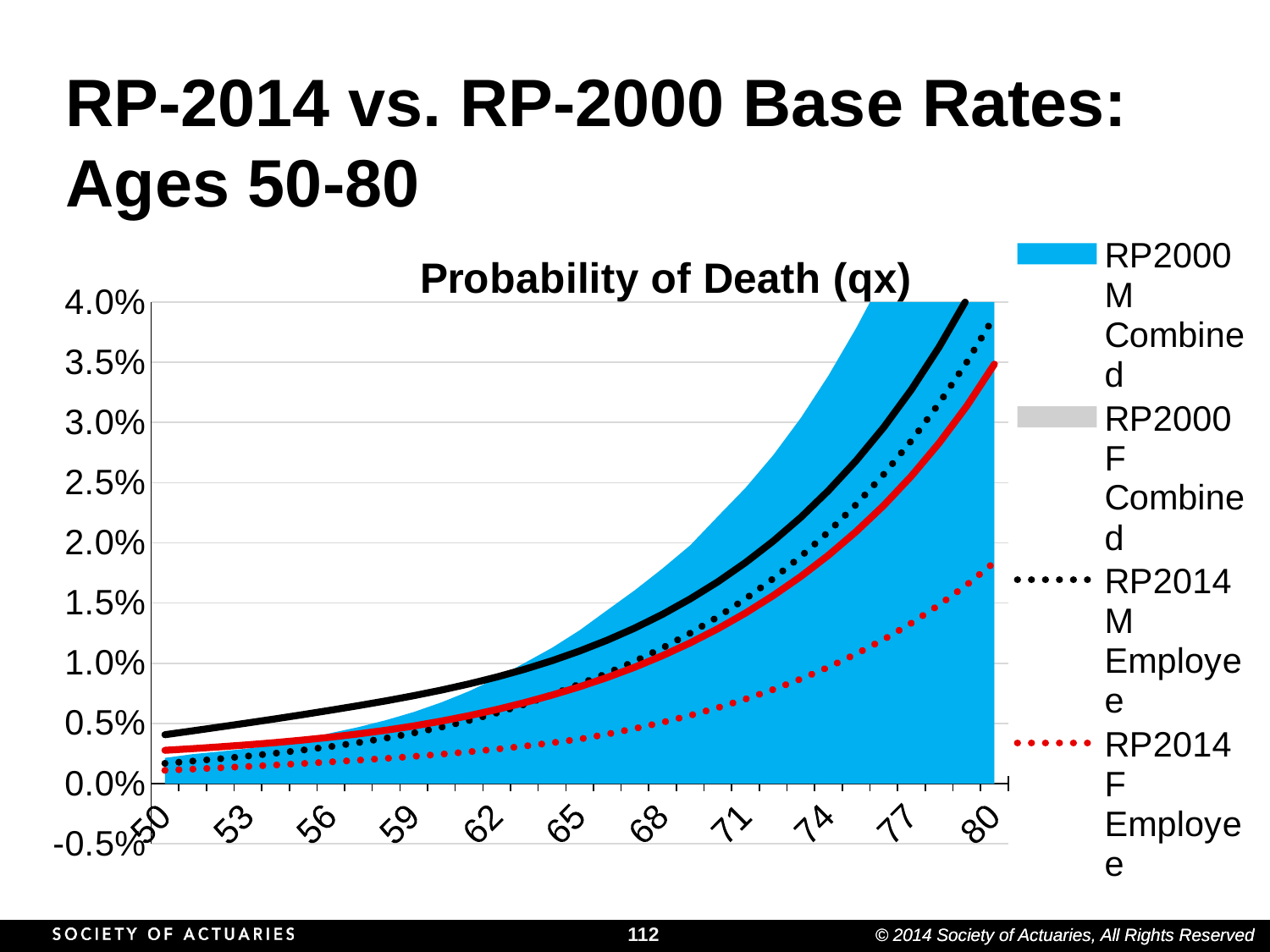
How many age labels are shown on the x axis? 11 Is the value for RP2014 M Employee at age 50 greater or less than 0.5%? less At age 80, which is larger: RP2014 M Employee or RP2014 F Employee? RP2014 M Employee How many series does the chart legend list? 4 Do the RP2014 M Employee values rise or fall as age increases from 50 to 80? rise Is the value for RP2014 F Employee at age 80 greater or less than 2.0%? less Which of the two RP2014 series is lowest at age 80? RP2014 F Employee What is the highest value labelled on the y axis? 4.0% Is the value for RP2014 F Employee at age 65 greater or less than 0.5%? less What is the title of the chart? Probability of Death (qx) What kind of chart is shown on the slide? combination area and line chart